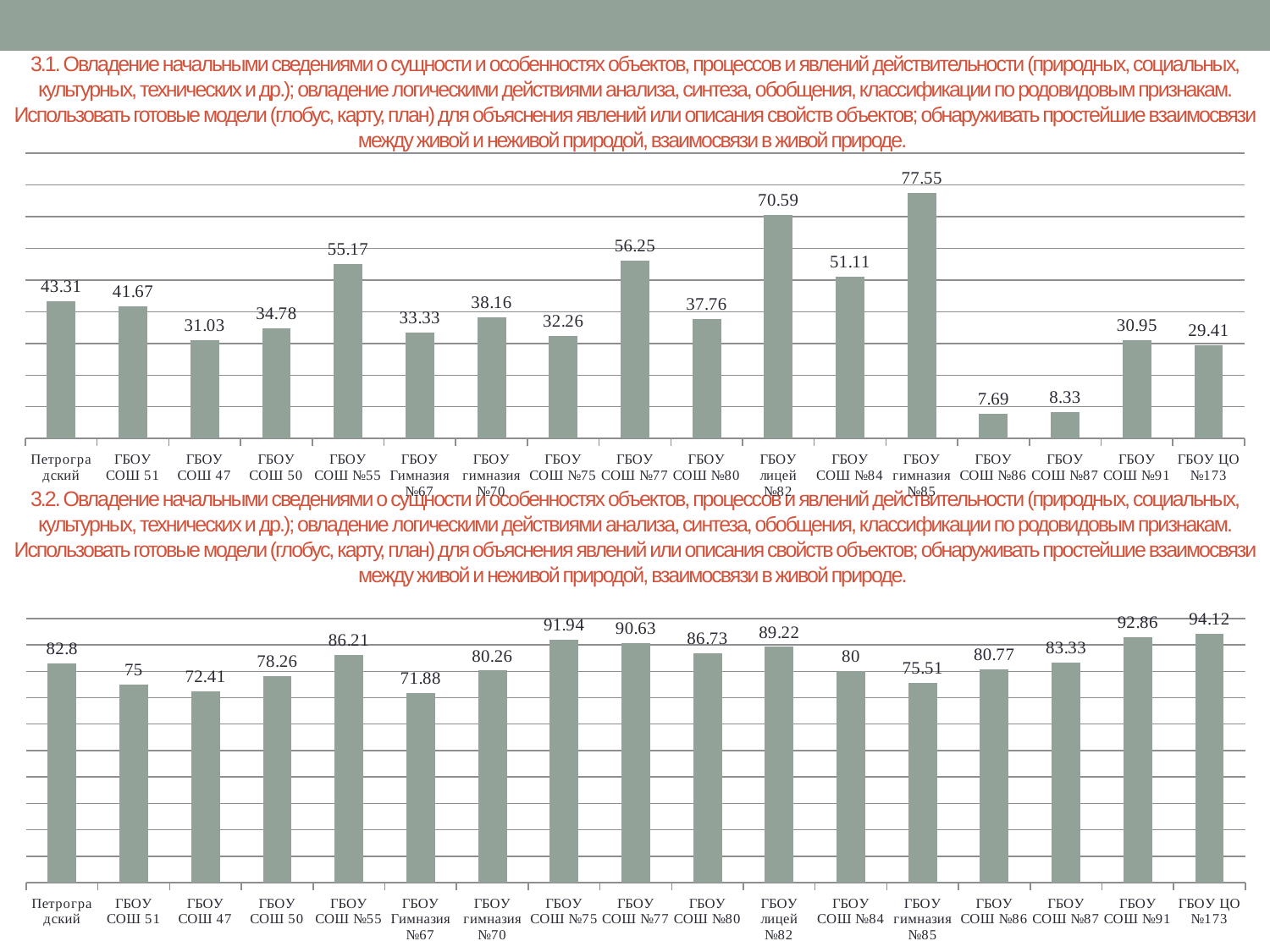
In the bottom chart (3.2), what is the difference between the values for ГБОУ ЦО №173 and ГБОУ СОШ №91? 1.26 In the top chart (3.1), what is the value for ГБОУ лицей №82? 70.59 In the bottom chart (3.2), what is the value for ГБОУ СОШ №75? 91.94 In the top chart (3.1), which category has the lowest value? ГБОУ СОШ №86 In the bottom chart (3.2), which category has the highest value? ГБОУ ЦО №173 In the top chart (3.1), which category has the highest value? ГБОУ гимназия №85 In the bottom chart (3.2), which category has the lowest value? ГБОУ Гимназия №67 In the bottom chart (3.2), which is larger: the value for Петроградский or the value for ГБОУ СОШ 51? Петроградский How many categories are shown in the top chart (3.1)? 17 What kind of chart is the bottom chart (3.2)? Bar chart In the top chart (3.1), which is larger: the value for ГБОУ СОШ №55 or the value for ГБОУ СОШ №84? ГБОУ СОШ №55 In the top chart (3.1), what is the difference between the values for ГБОУ гимназия №85 and ГБОУ лицей №82? 6.96